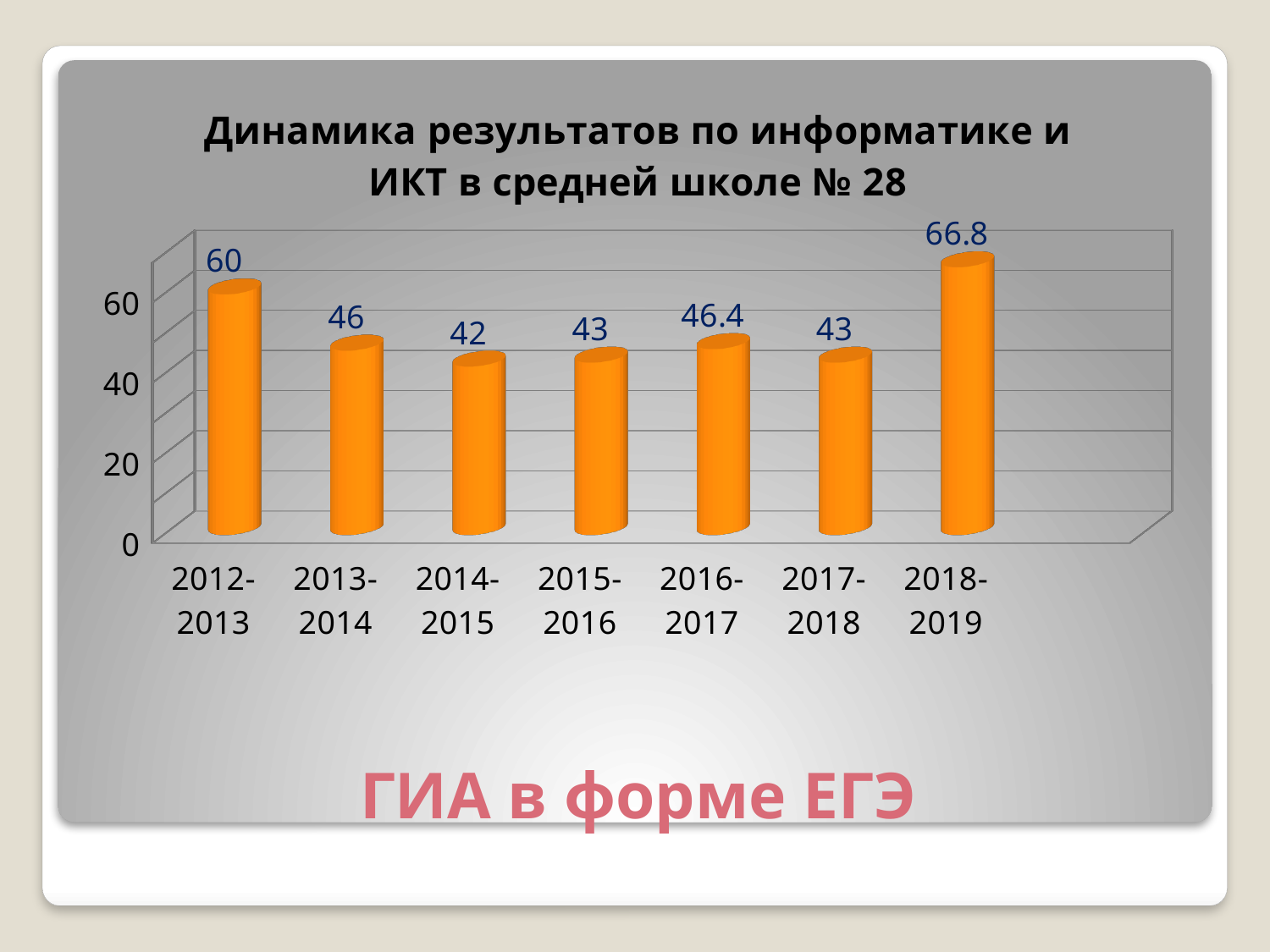
Is the value for 2017-2018 greater or less than 40? greater How many years are shown on the chart? 7 What is the value for 2018-2019? 66.8 What kind of chart is shown on the slide? bar chart What is the value for 2012-2013? 60 Which is larger, the value for 2013-2014 or the value for 2016-2017? 2016-2017 What is the value for 2016-2017? 46.4 Which year has the highest value? 2018-2019 Which year has the lowest value? 2014-2015 What is the title of the chart? Динамика результатов по информатике и ИКТ в средней школе № 28 What is the difference between the values for 2013-2014 and 2014-2015? 4 What is the difference between the values for 2018-2019 and 2012-2013? 6.8